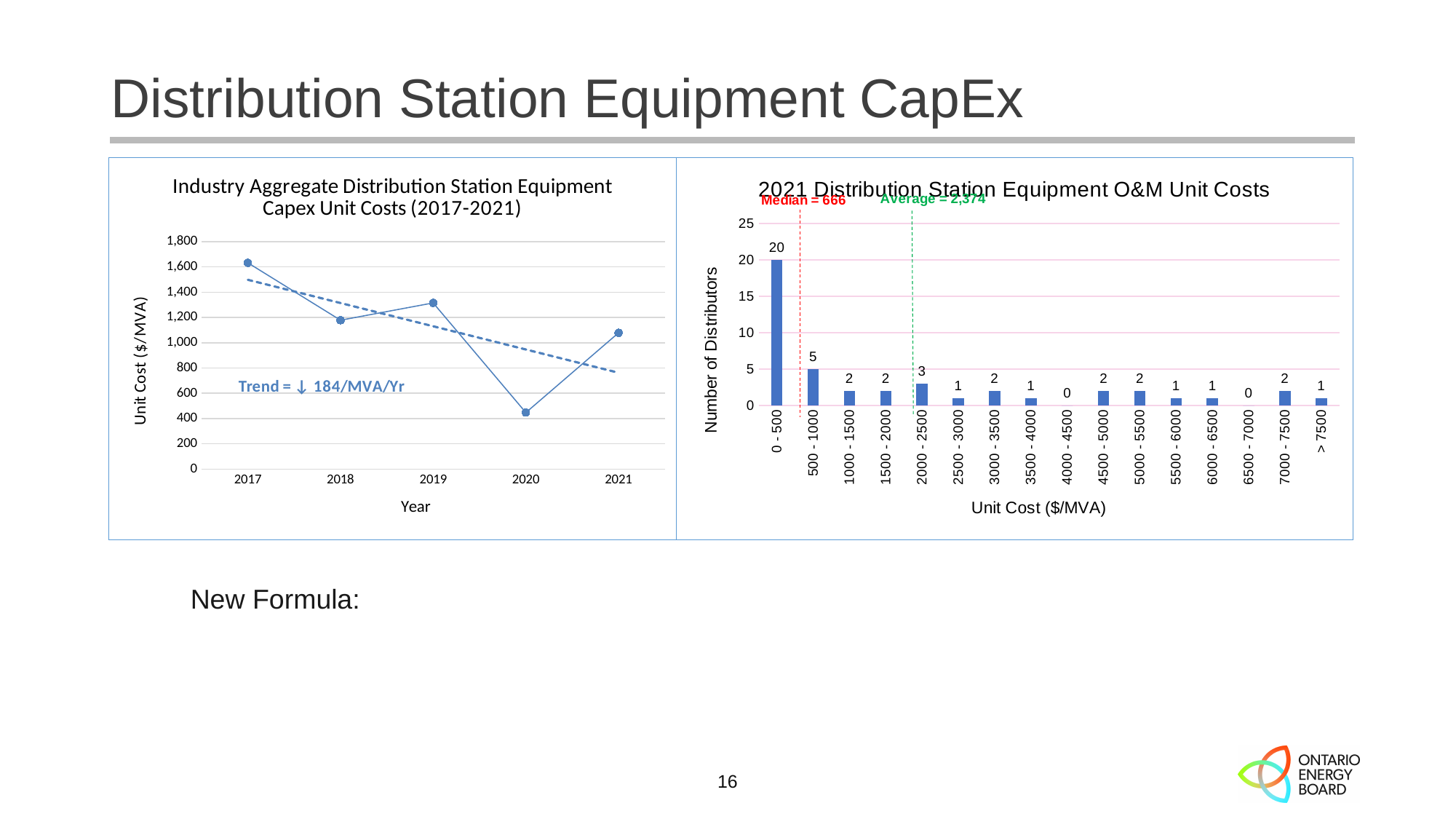
What kind of chart is the left chart (Industry Aggregate Distribution Station Equipment Capex Unit Costs)? line chart In the right chart (2021 Distribution Station Equipment O&M Unit Costs), how many unit cost bins are shown on the x axis? 16 In the right chart (2021 Distribution Station Equipment O&M Unit Costs), which unit cost bin has the most distributors? 0 - 500 In the left chart (Industry Aggregate Distribution Station Equipment Capex Unit Costs), which year has the highest unit cost? 2017 In the right chart (2021 Distribution Station Equipment O&M Unit Costs), how many distributors are in the 0 - 500 bin? 20 In the left chart (Industry Aggregate Distribution Station Equipment Capex Unit Costs), which year has the lowest unit cost? 2020 In the right chart (2021 Distribution Station Equipment O&M Unit Costs), what is the difference in number of distributors between the 0 - 500 bin and the 500 - 1000 bin? 15 In the right chart (2021 Distribution Station Equipment O&M Unit Costs), how many distributors are in the 2000 - 2500 bin? 3 In the right chart (2021 Distribution Station Equipment O&M Unit Costs), what is the median value shown? 666 In the right chart (2021 Distribution Station Equipment O&M Unit Costs), how many distributors are in the 500 - 1000 bin? 5 In the left chart (Industry Aggregate Distribution Station Equipment Capex Unit Costs), is the unit cost for 2020 greater or less than 600? less In the right chart (2021 Distribution Station Equipment O&M Unit Costs), what is the average value shown? 2,374